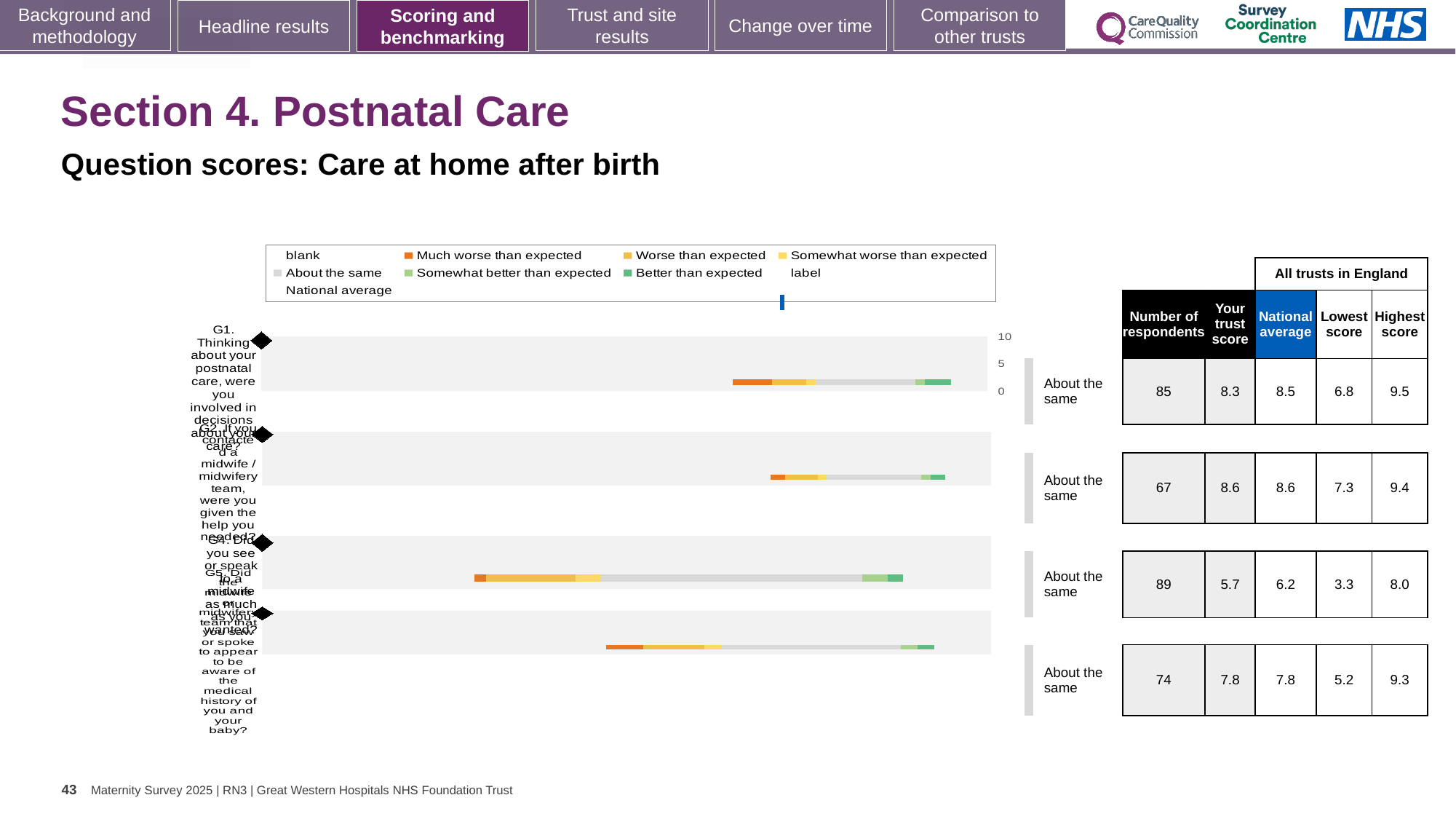
How many respondents are listed for question G4? 89 Which question has the lowest trust score? G4 Which question has the highest trust score? G2 What is the subtitle describing the chart's topic? Question scores: Care at home after birth Which has the larger trust score, question G2 or question G5? G2 What is the highest score among all trusts in England for question G5? 9.3 What is the trust score for question G1 (involved in decisions about postnatal care)? 8.3 What is the national average for question G4? 6.2 What is the difference between the national average and the trust score for question G1? 0.2 How many questions (categories) are plotted in the chart? 4 What benchmark rating is shown next to each of the four questions? About the same What kind of chart is shown on the slide? bar chart